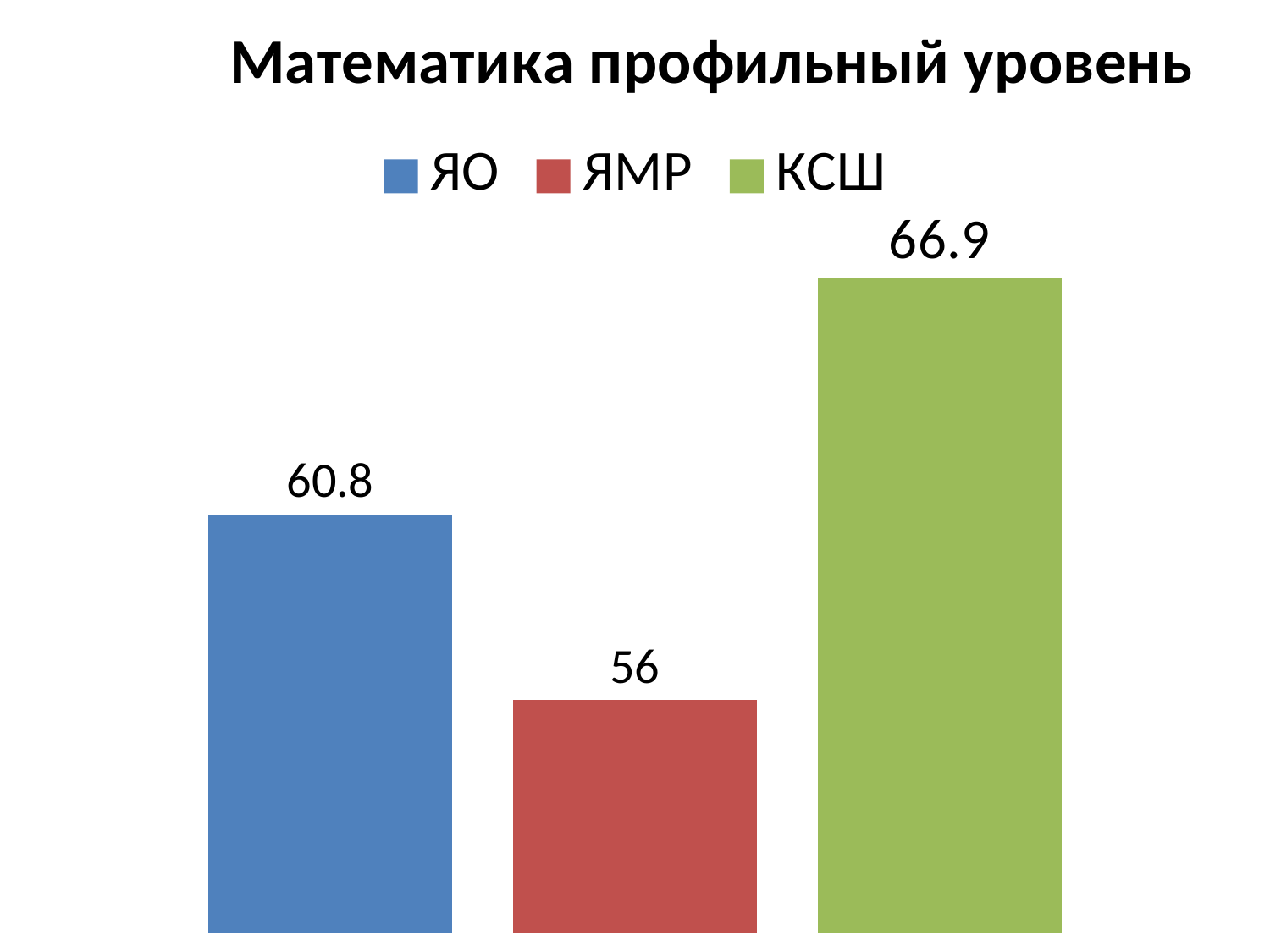
Which series has the lowest value? ЯМР What is the value for ЯМР? 56 What is the value for ЯО? 60.8 How many series does the legend list? 3 What is the difference between the values for ЯО and ЯМР? 4.8 What is the value for КСШ? 66.9 What is the difference between the values for КСШ and ЯО? 6.1 Which is larger, the value for ЯО or the value for ЯМР? ЯО What is the title of the chart? Математика профильный уровень What kind of chart is shown on the slide? bar chart Which series has the highest value? КСШ How many bars are plotted on the chart? 3